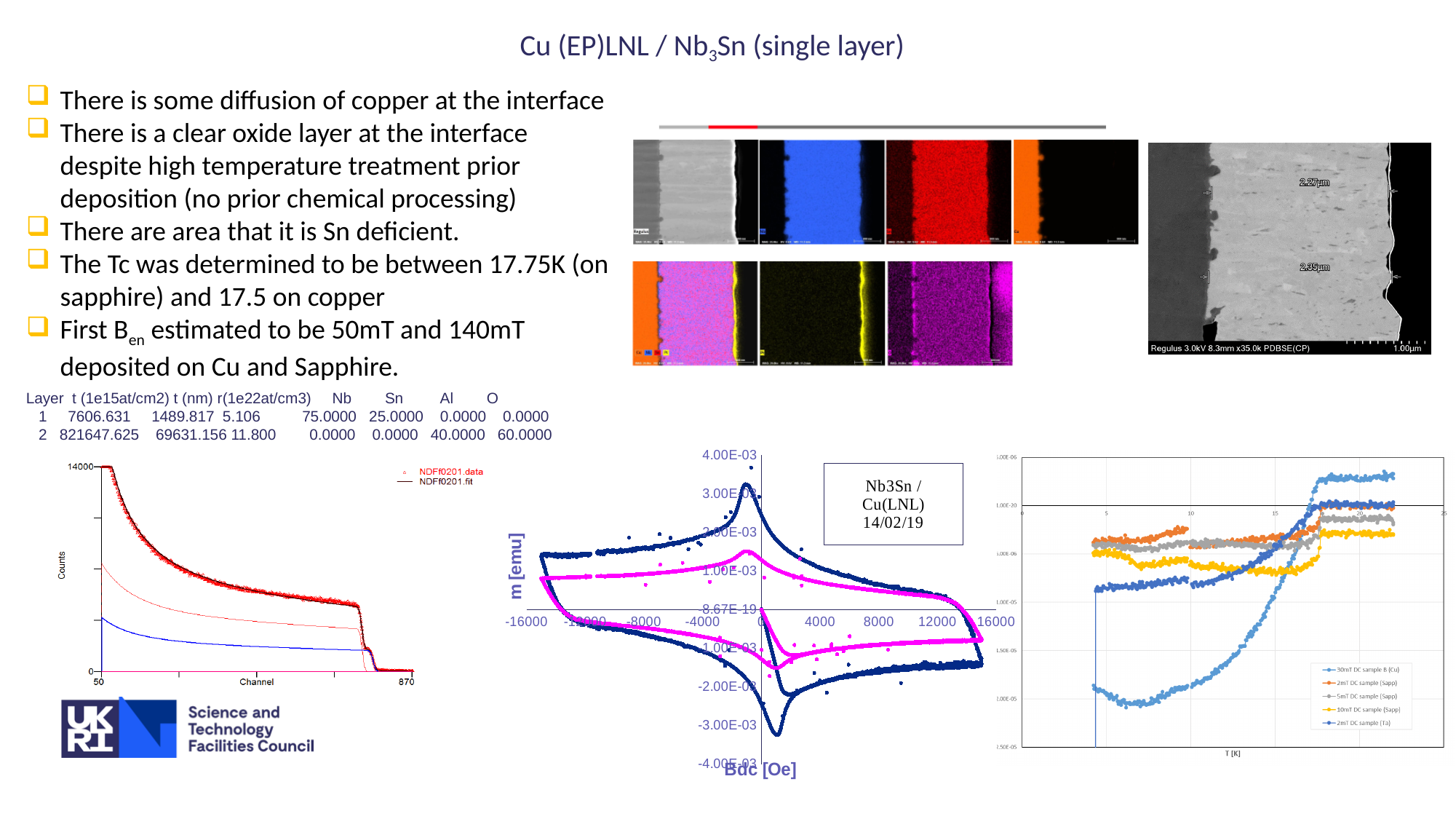
On the bottom-left chart, how many entries does the legend list? 2 On the right-hand chart, how many series does the legend list? 5 On the middle chart, what is the label of the x axis? Bdc [Oe] On the right-hand chart, what is the label of the x axis? T [K] On the middle chart, what is the highest value shown on the y axis? 4.00E-03 On the bottom-left chart, do the counts generally rise or fall as the channel increases? fall On the middle chart, what is the label of the y axis? m [emu] On the right-hand chart, does the series '30mT DC sample B (Cu)' rise or fall as T increases? rise On the bottom-left chart, what is the highest value shown on the Counts axis? 14000 On the middle chart, what is the largest value shown on the x axis? 16000